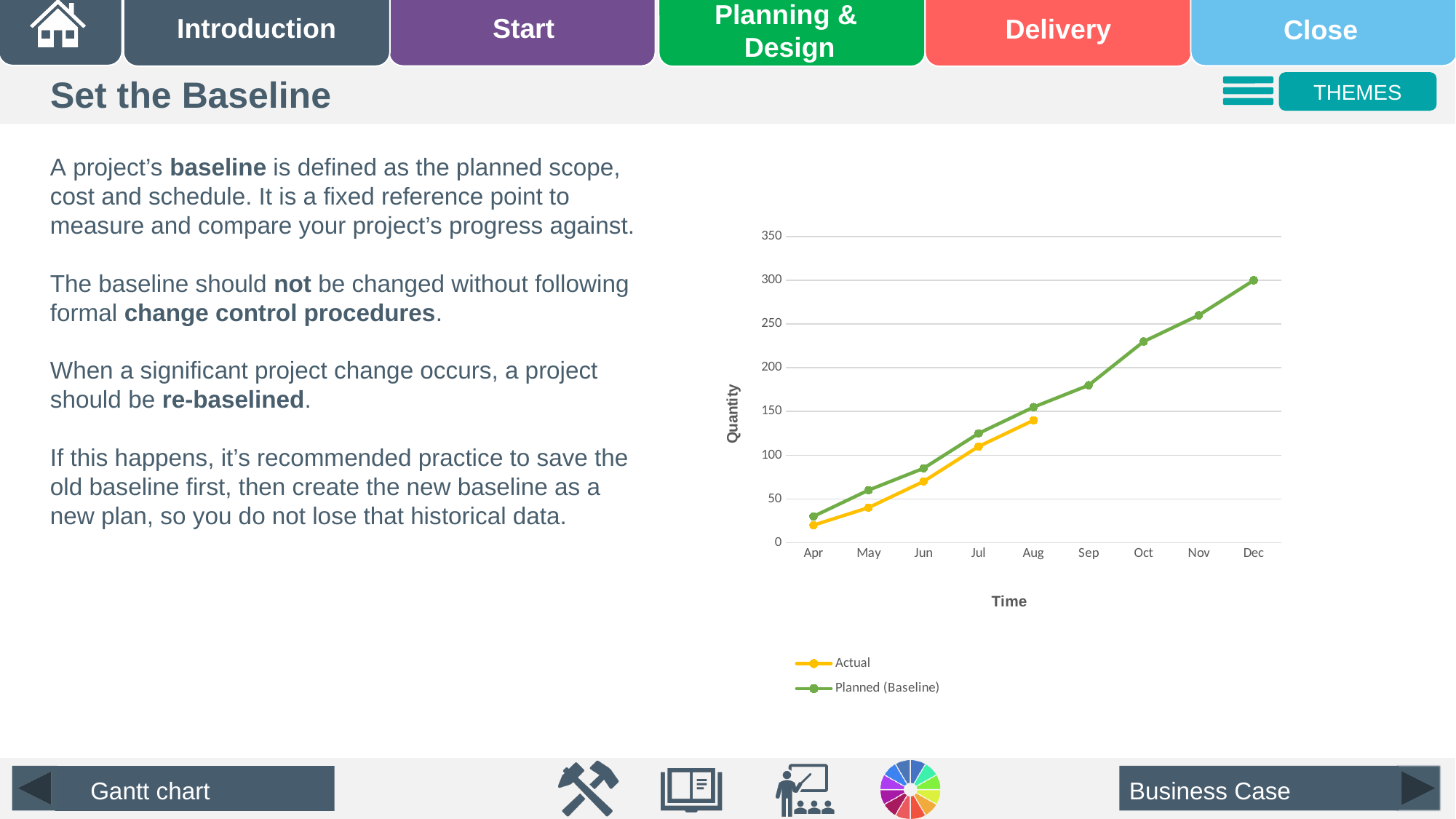
Does the Planned (Baseline) series rise or fall from Apr to Dec? Rise In Aug, which series has the larger value, Actual or Planned (Baseline)? Planned (Baseline) What kind of chart is shown on the slide? Line chart In which month is the Actual series lowest? Apr What is the Planned (Baseline) value for Dec? 300 Which month is the last one with a plotted Actual value? Aug How many series does the chart legend list? 2 Is the Actual value for Aug greater or less than 100? greater In which month is the Planned (Baseline) series highest? Dec What is the title of the vertical axis of the chart? Quantity Is the Planned (Baseline) value for Sep greater or less than 200? less How many months are shown on the x axis of the chart? 9